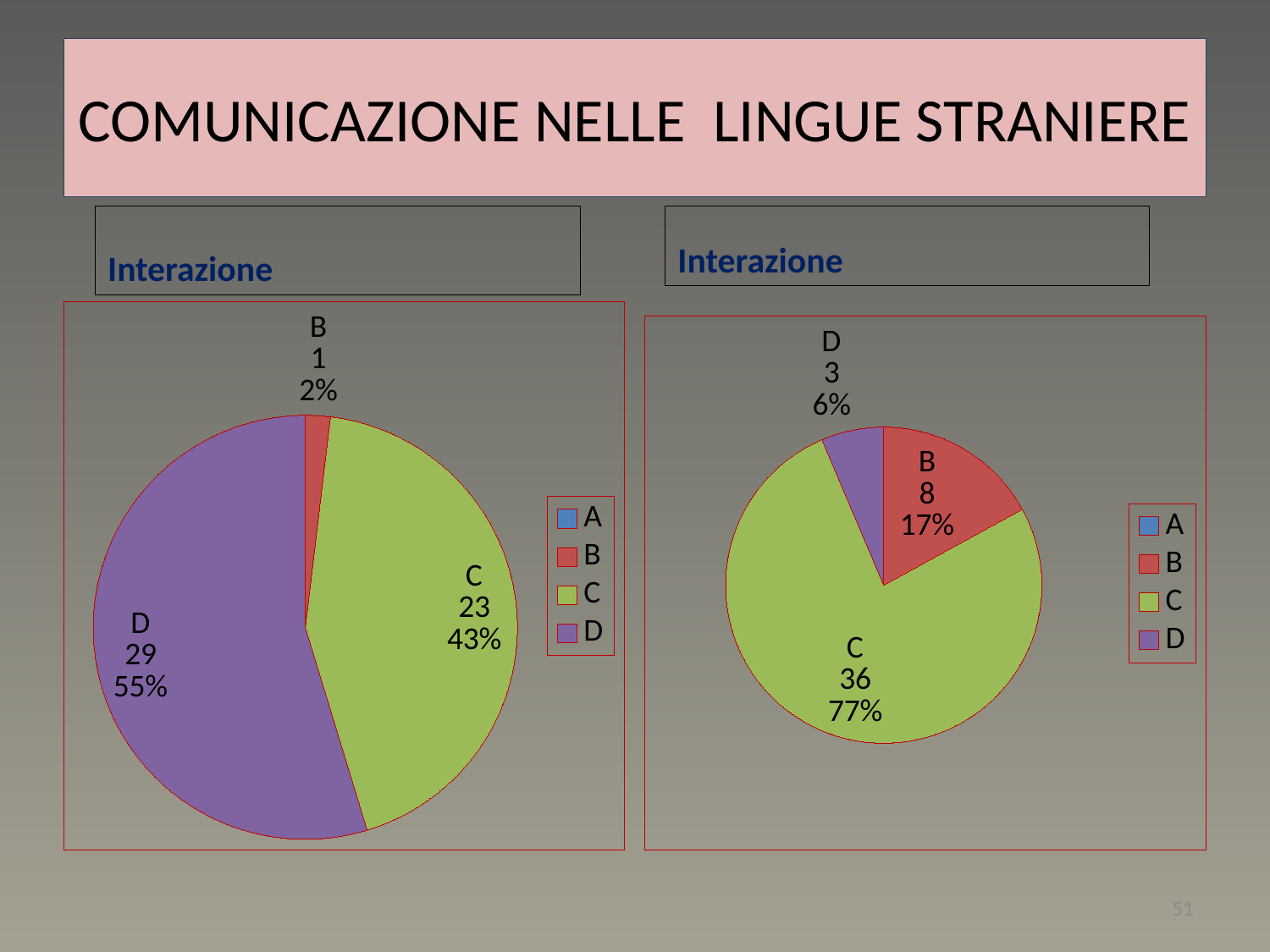
On the left pie chart, what is the value for category D? 29 On the right pie chart, which is larger, the value for B or the value for D? B What type of chart is shown on the right side of the slide? Pie chart On the right pie chart, which category has the largest slice? C On the left pie chart, what percentage share does category C have? 43% On the left pie chart, which category has the largest slice? D On the right pie chart, what is the value for category B? 8 On the left pie chart, what is the difference between the values for D and C? 6 On the right pie chart, what percentage share does category C have? 77% On the left pie chart, which labelled category has the smallest slice? B On the right pie chart, what is the difference between the values for C and B? 28 How many entries does the legend of the left pie chart list? 4